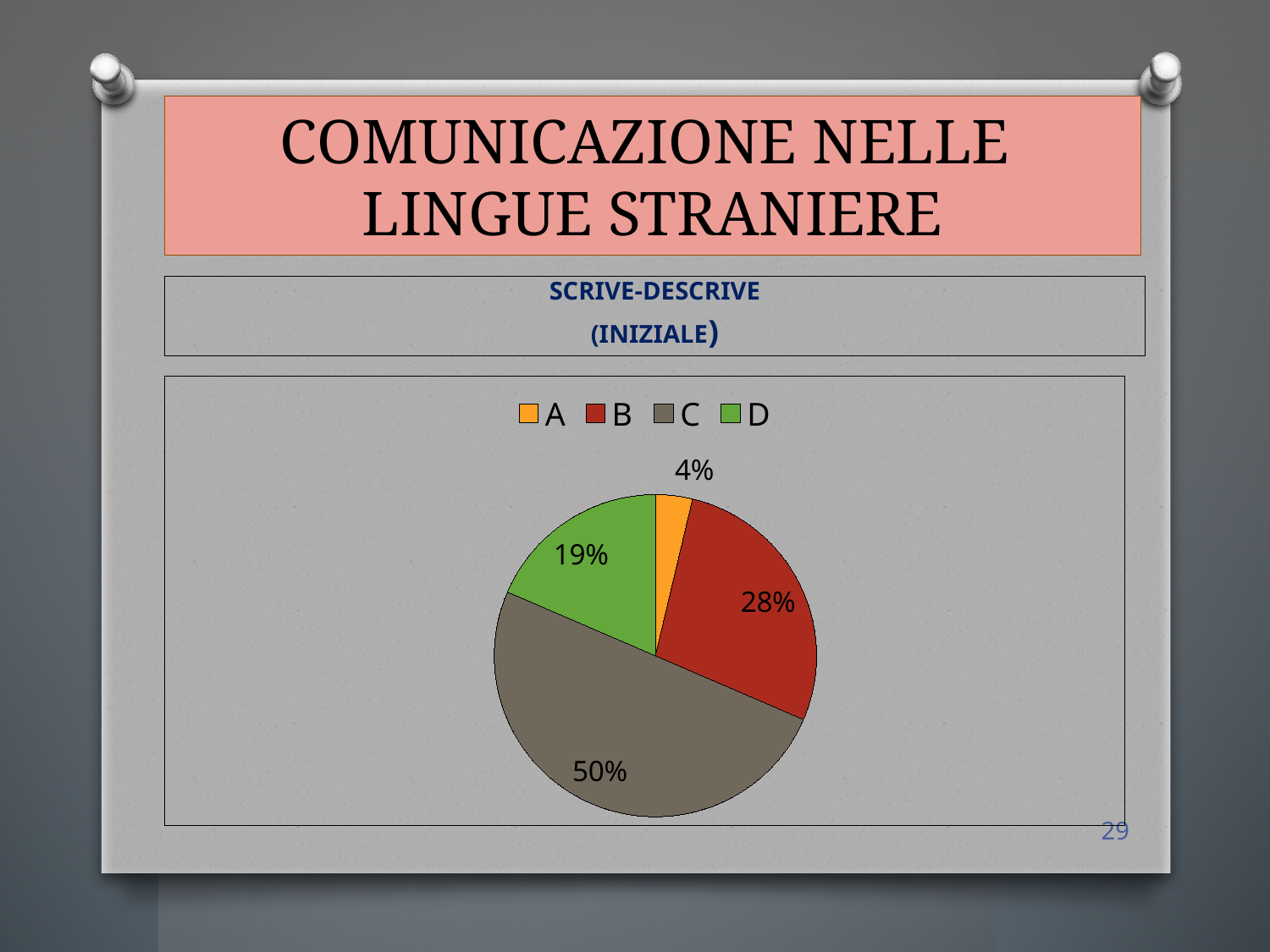
How many categories does the pie chart have? 4 What kind of chart is shown on the slide? pie chart Which is larger, the slice for B or the slice for D? B What share of the pie does category C have? 50% What colour is the slice for category D? green What share of the pie does category D have? 19% Which category has the smallest slice of the pie? A What share of the pie does category A have? 4% What is the difference in percentage points between category C and category B? 22 Which category has the largest slice of the pie? C What is the subtitle shown above the chart? SCRIVE-DESCRIVE (INIZIALE)